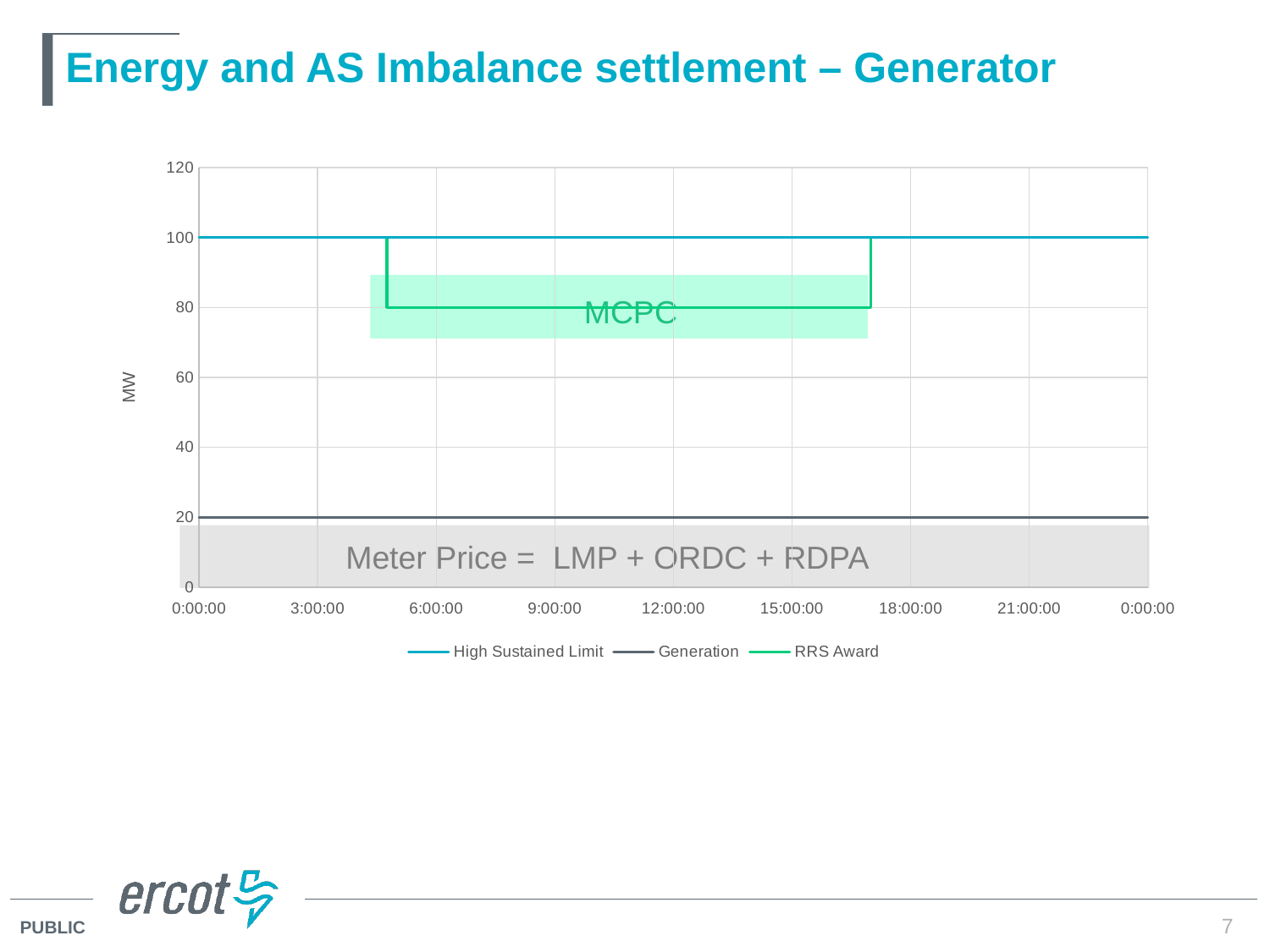
What is the value of the RRS Award line at 12:00:00? 80 Which is larger, the High Sustained Limit or the Generation value? High Sustained Limit What is the value of the Generation line in MW? 20 What is the value of the High Sustained Limit line in MW? 100 What is the difference between the High Sustained Limit and the Generation value? 80 What is the difference between the RRS Award value at 12:00:00 and the Generation value? 60 Does the Generation line rise, fall, or stay flat across the x axis? stays flat What kind of chart is shown on the slide? line chart Is the Generation value greater or less than 40? less How many series does the legend list? 3 What is the label on the y axis? MW